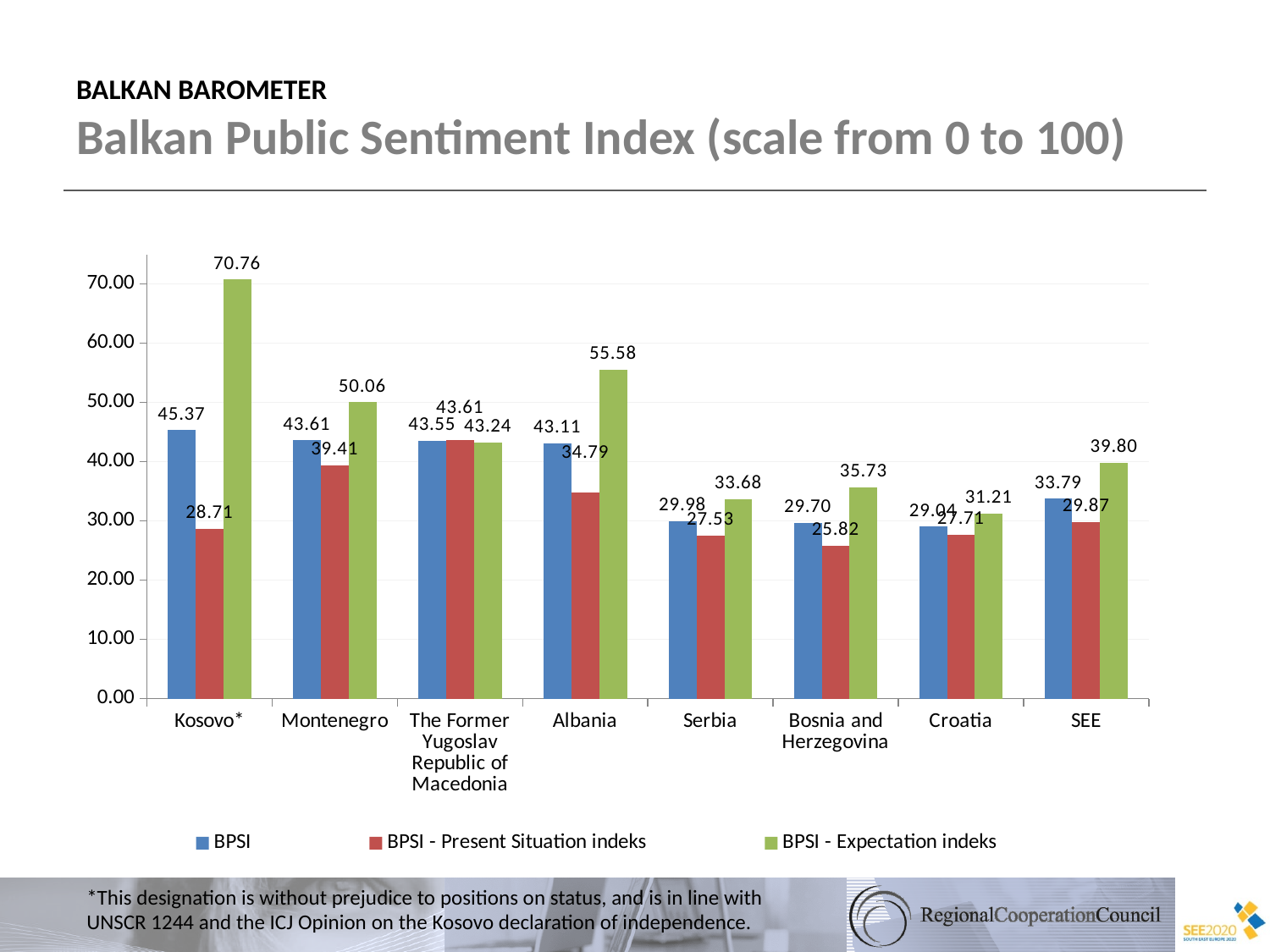
What kind of chart is shown on the slide? bar chart How many series does the legend list? 3 How many categories are shown on the x axis of the chart? 8 Which is larger, the BPSI value for Montenegro or the BPSI value for Albania? Montenegro Is the BPSI - Expectation indeks value for Serbia greater or less than 30.00? greater What is the BPSI - Expectation indeks value for Kosovo*? 70.76 Which category has the lowest BPSI - Present Situation indeks value? Bosnia and Herzegovina Which category has the highest BPSI - Expectation indeks value? Kosovo* What is the BPSI - Expectation indeks value for SEE? 39.80 What is the difference between the BPSI - Expectation indeks and the BPSI - Present Situation indeks for Kosovo*? 42.05 What is the BPSI value for Albania? 43.11 What is the title of the chart on the slide? Balkan Public Sentiment Index (scale from 0 to 100)